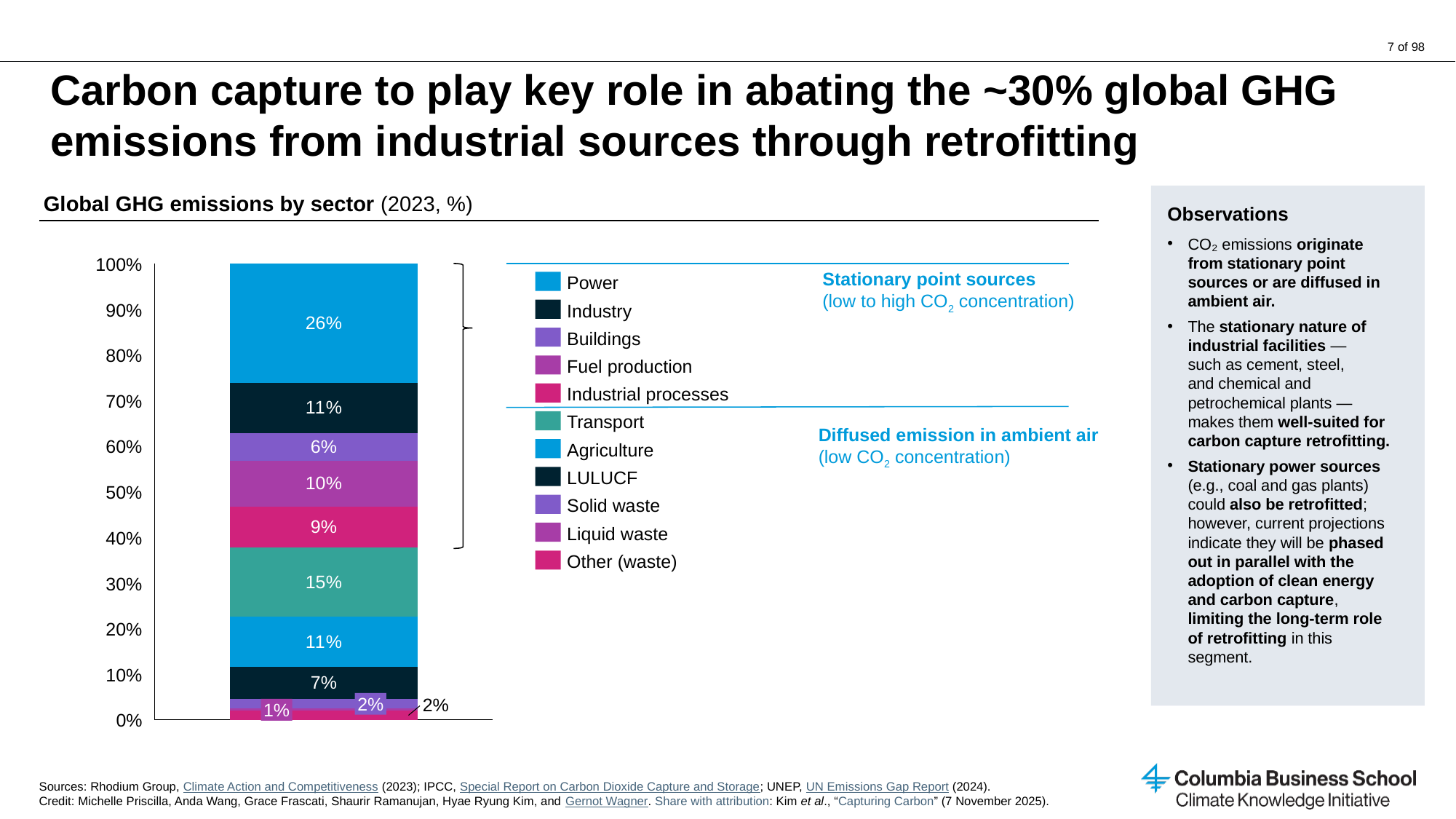
What type of chart is shown on the slide? Stacked bar chart Which sector has the smallest share of global GHG emissions in the chart? Liquid waste What is the value for Power in the Global GHG emissions by sector chart? 26% What year does the Global GHG emissions by sector chart refer to? 2023 What is the value for Fuel production in the Global GHG emissions by sector chart? 10% Which sector has the largest share of global GHG emissions in the chart? Power What is the value for LULUCF in the Global GHG emissions by sector chart? 7% What is the difference between the Power and Industry values in the chart? 15% Which is larger in the chart, Transport or Fuel production? Transport What is the value for Transport in the Global GHG emissions by sector chart? 15% What is the combined value of Buildings and Industrial processes in the chart? 15% How many sectors does the legend of the chart list? 11